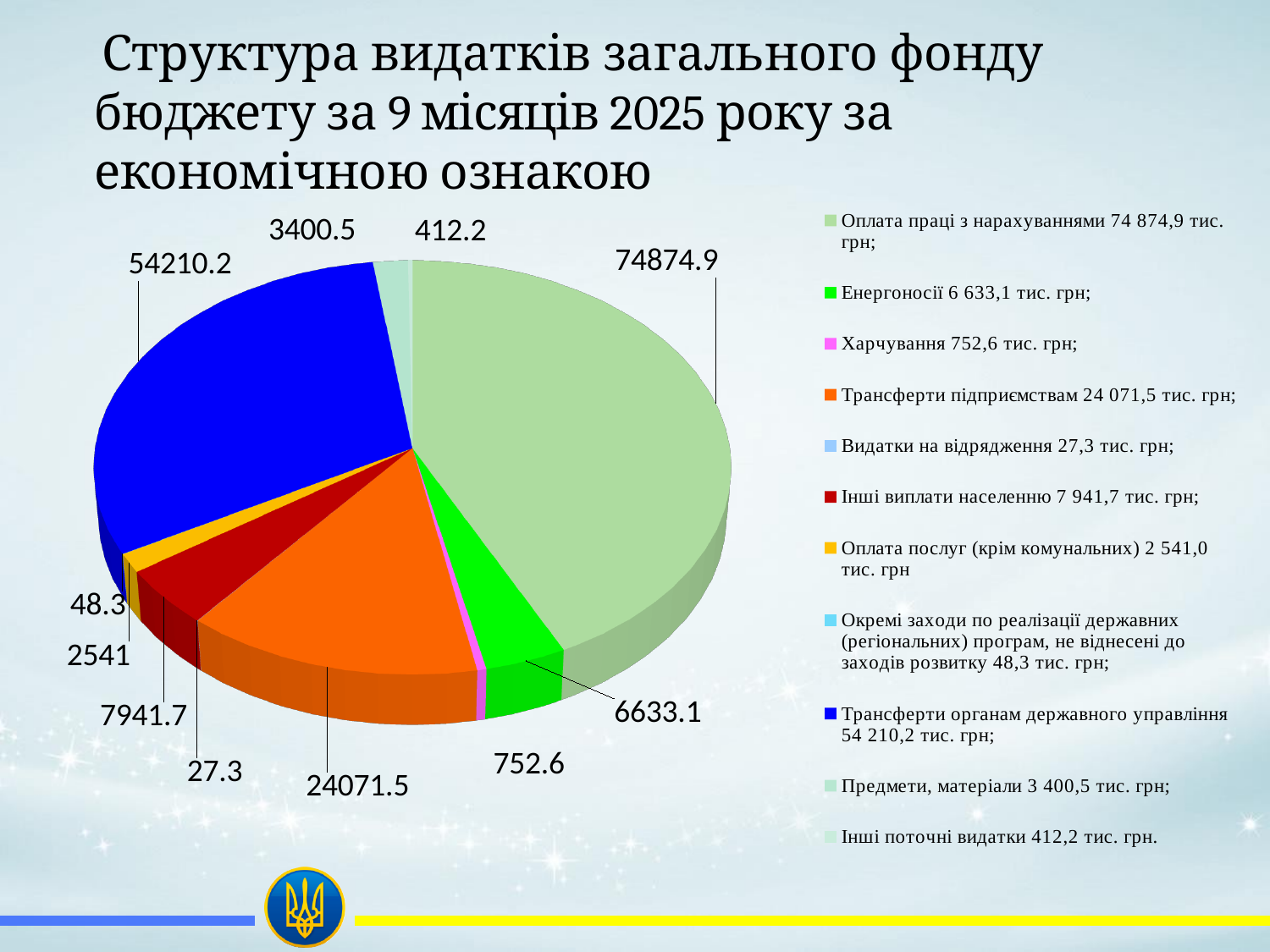
What is the difference between the values for Трансферти підприємствам and Інші виплати населенню? 16129.8 What is the value shown for Оплата праці з нарахуваннями? 74874.9 How many categories does the pie chart have? 11 What colour is the slice for Трансферти органам державного управління? blue What is the value shown for Трансферти органам державного управління? 54210.2 What is the value shown for Енергоносії? 6633.1 What is the value shown for Видатки на відрядження? 27.3 Which is larger: Трансферти підприємствам or Інші виплати населенню? Трансферти підприємствам Which category has the smallest value in the pie chart? Видатки на відрядження What is the difference between the values for Оплата праці з нарахуваннями and Трансферти органам державного управління? 20664.7 Which category has the largest value in the pie chart? Оплата праці з нарахуваннями What type of chart is shown on the slide? pie chart